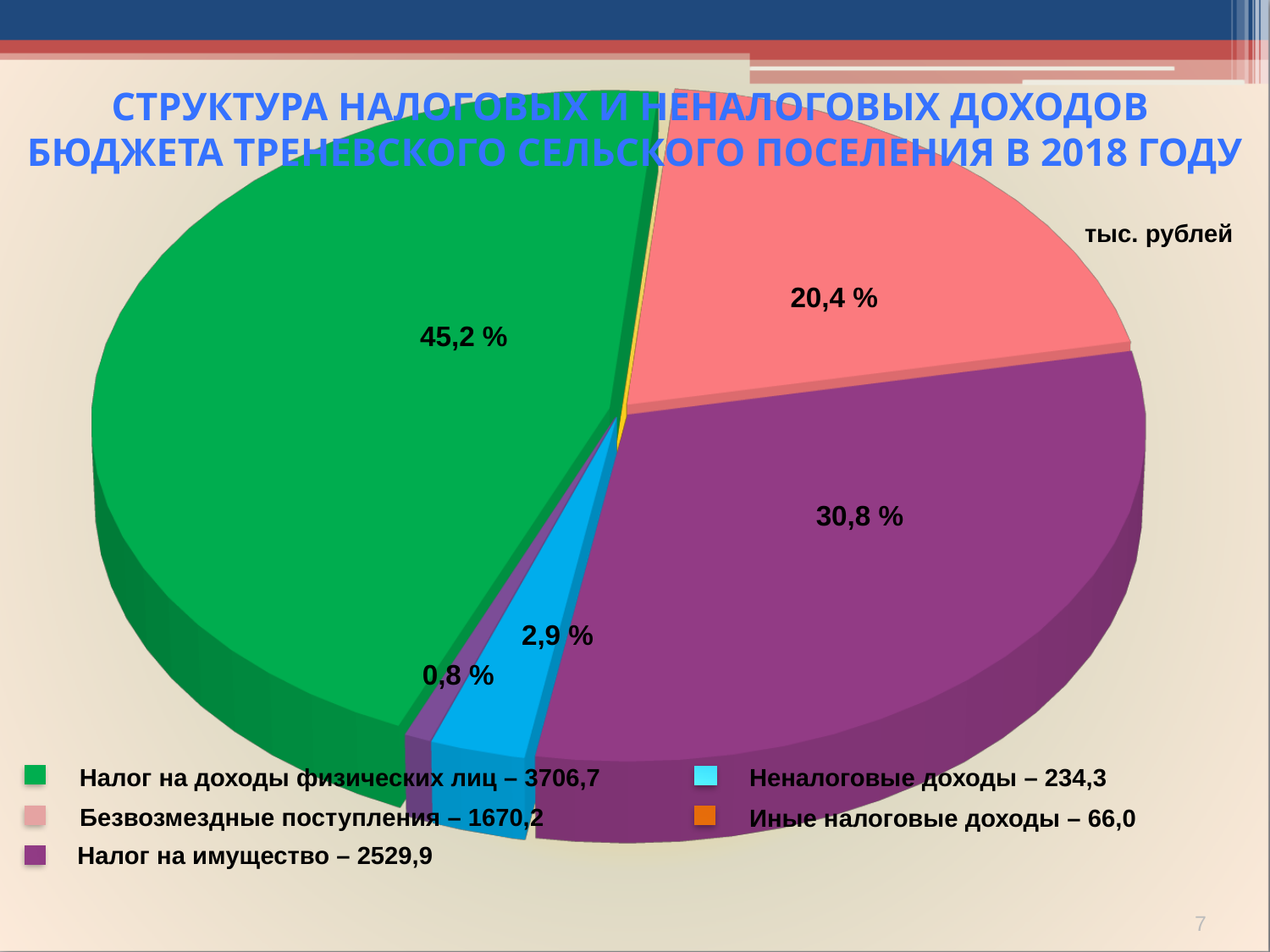
What is the value for Иные налоговые доходы in the legend? 66,0 What share of the pie does Неналоговые доходы have? 2,9 % Which category has the largest share of the pie? Налог на доходы физических лиц What share of the pie does Налог на имущество have? 30,8 % What share of the pie does Налог на доходы физических лиц have? 45,2 % What is the value for Безвозмездные поступления in the legend? 1670,2 What is the difference between the values for Налог на доходы физических лиц and Налог на имущество? 1176,8 Which category has the smallest share of the pie? Иные налоговые доходы Which is larger: Безвозмездные поступления or Неналоговые доходы? Безвозмездные поступления What kind of chart is shown on the slide? pie chart How many categories does the legend list? 5